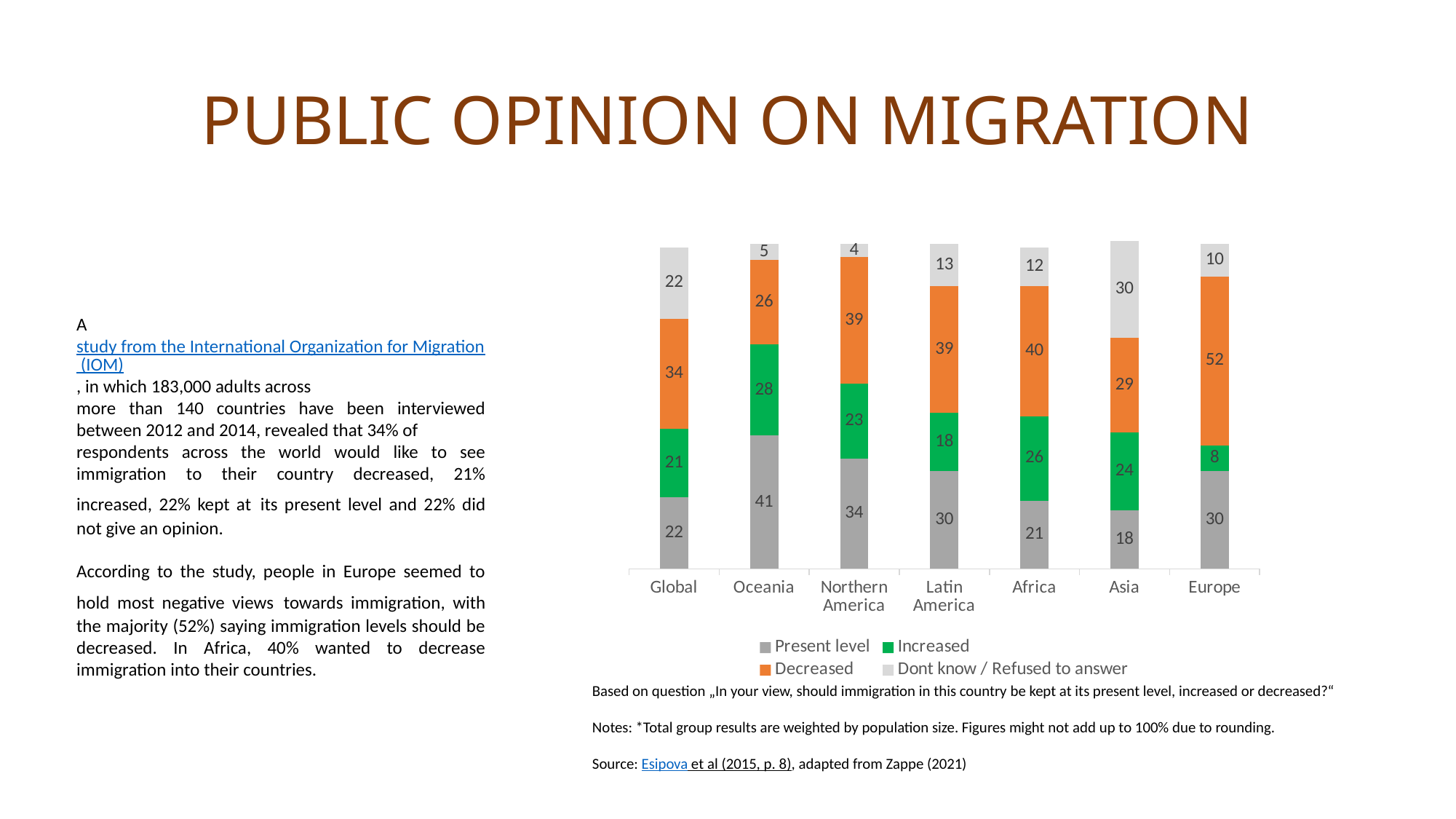
What is the 'Decreased' value for Europe? 52 What is the 'Dont know / Refused to answer' value for Asia? 30 What is the difference between the 'Decreased' values for Europe and Africa? 12 How many regions (categories) are shown on the x axis of the chart? 7 What is the 'Present level' value for Oceania? 41 How many series does the chart legend list? 4 What is the total of the stacked bar for Latin America? 100 Which is larger: the 'Increased' value for Oceania or for Africa? Oceania What kind of chart is shown on the slide? Stacked bar chart Which region has the highest 'Decreased' value? Europe Which region has the lowest 'Increased' value? Europe Which region has the lowest 'Present level' value? Asia